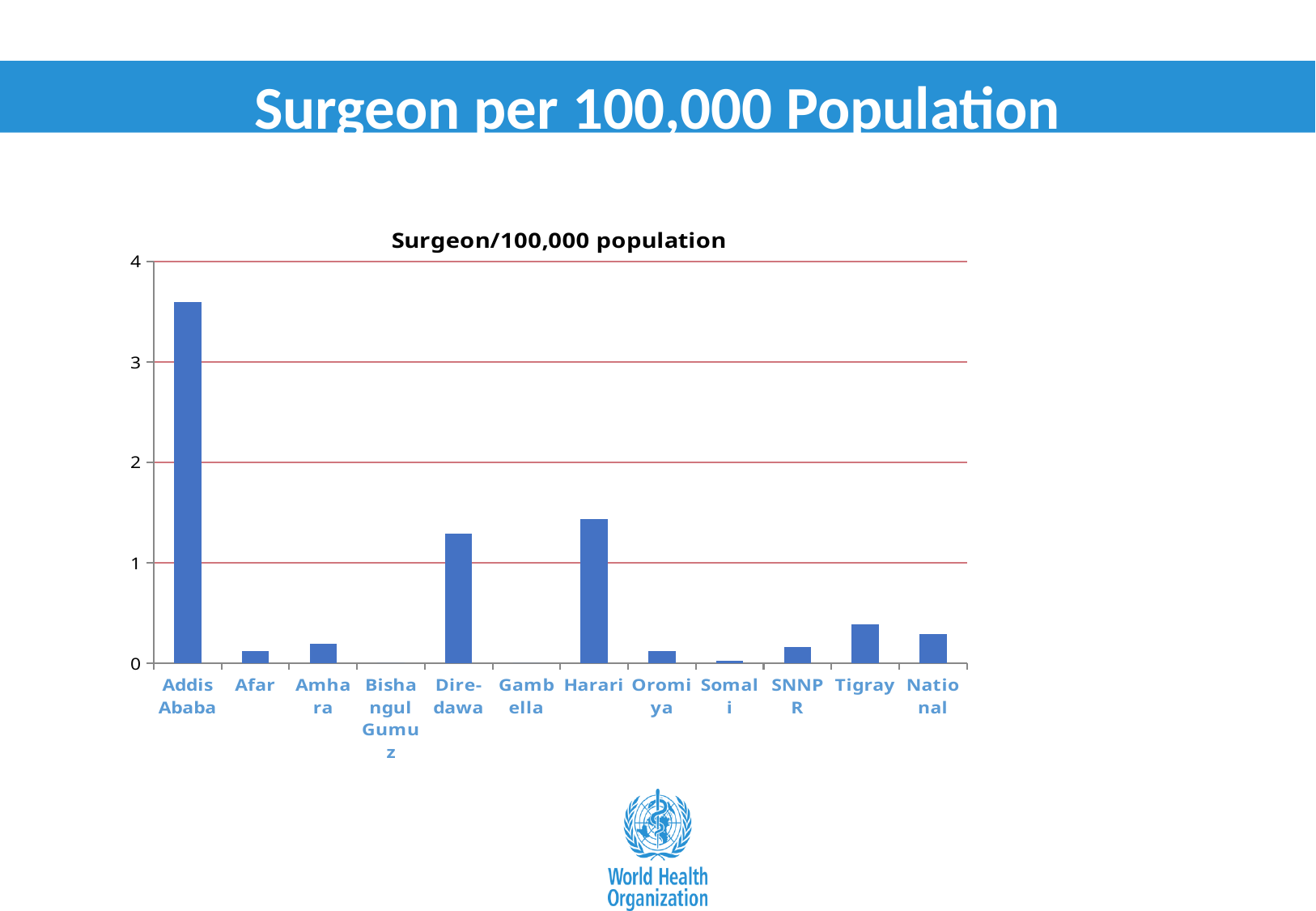
How many regions (categories) are shown on the x axis of the chart? 12 Is the value for Harari greater or less than 2? less Is the value for Addis Ababa greater or less than 3? greater What is the title of the chart? Surgeon/100,000 population Which region has the highest number of surgeons per 100,000 population? Addis Ababa Which has a higher value, Harari or Addis Ababa? Addis Ababa What kind of chart is shown on the slide? bar chart Which has a higher value, Tigray or Afar? Tigray Is the National value greater or less than 1? less What colour are the bars in the chart? blue